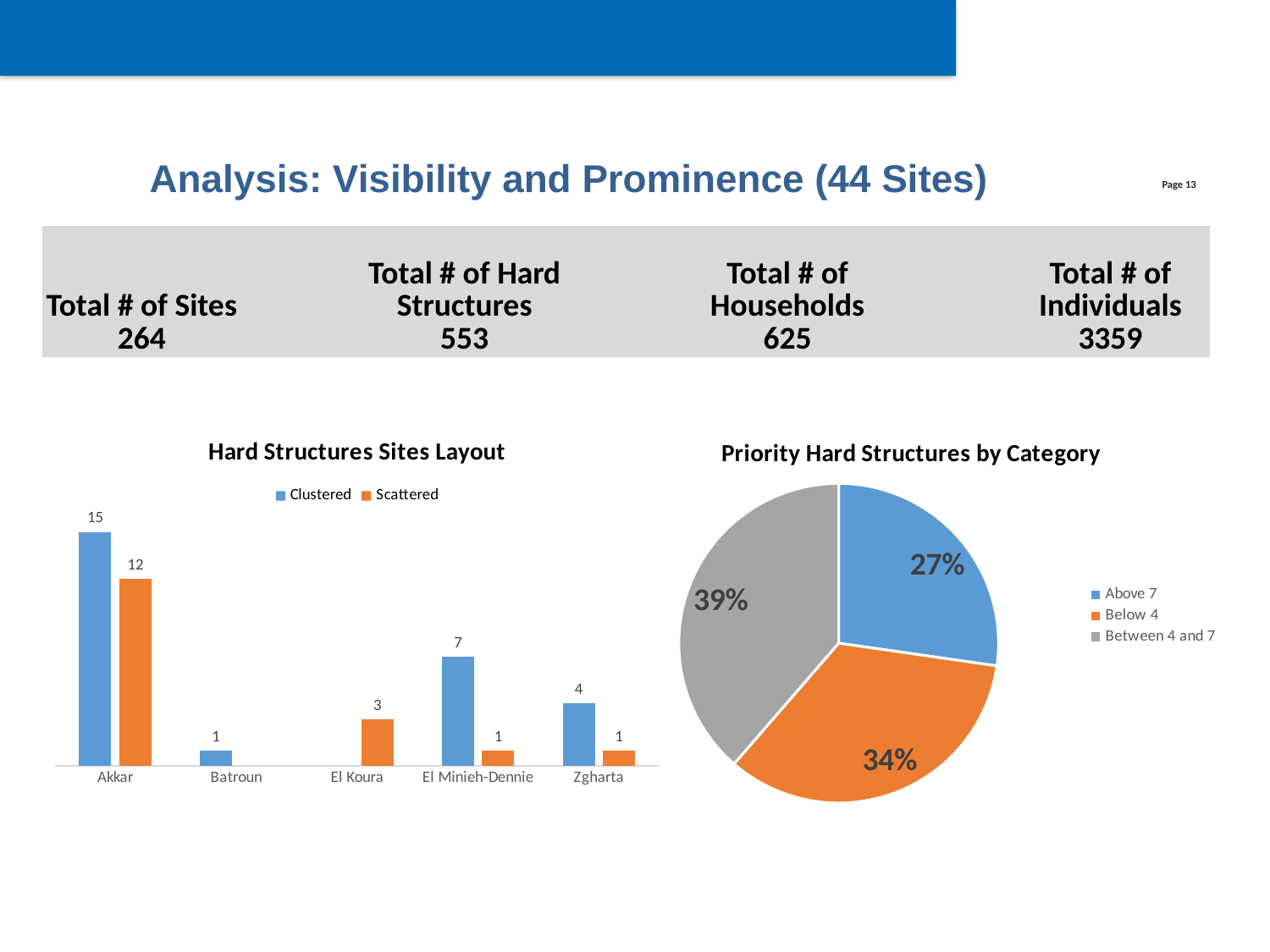
In the Priority Hard Structures by Category pie chart, what share is Between 4 and 7? 39% How many series does the legend of the Hard Structures Sites Layout chart list? 2 What kind of chart is the Hard Structures Sites Layout chart? Bar chart In the Hard Structures Sites Layout chart, what is the Scattered value for El Koura? 3 What kind of chart is the Priority Hard Structures by Category chart? Pie chart In the Hard Structures Sites Layout chart, which category has the highest Clustered value? Akkar How many categories are shown on the x axis of the Hard Structures Sites Layout chart? 5 In the Hard Structures Sites Layout chart, which is larger: the Clustered value for Zgharta or the Scattered value for El Koura? Clustered value for Zgharta In the Hard Structures Sites Layout chart, what is the Clustered value for El Minieh-Dennie? 7 In the Priority Hard Structures by Category pie chart, which category has the smallest share? Above 7 In the Hard Structures Sites Layout chart, what is the difference between the Clustered and Scattered values for Akkar? 3 In the Hard Structures Sites Layout chart, what is the Clustered value for Akkar? 15